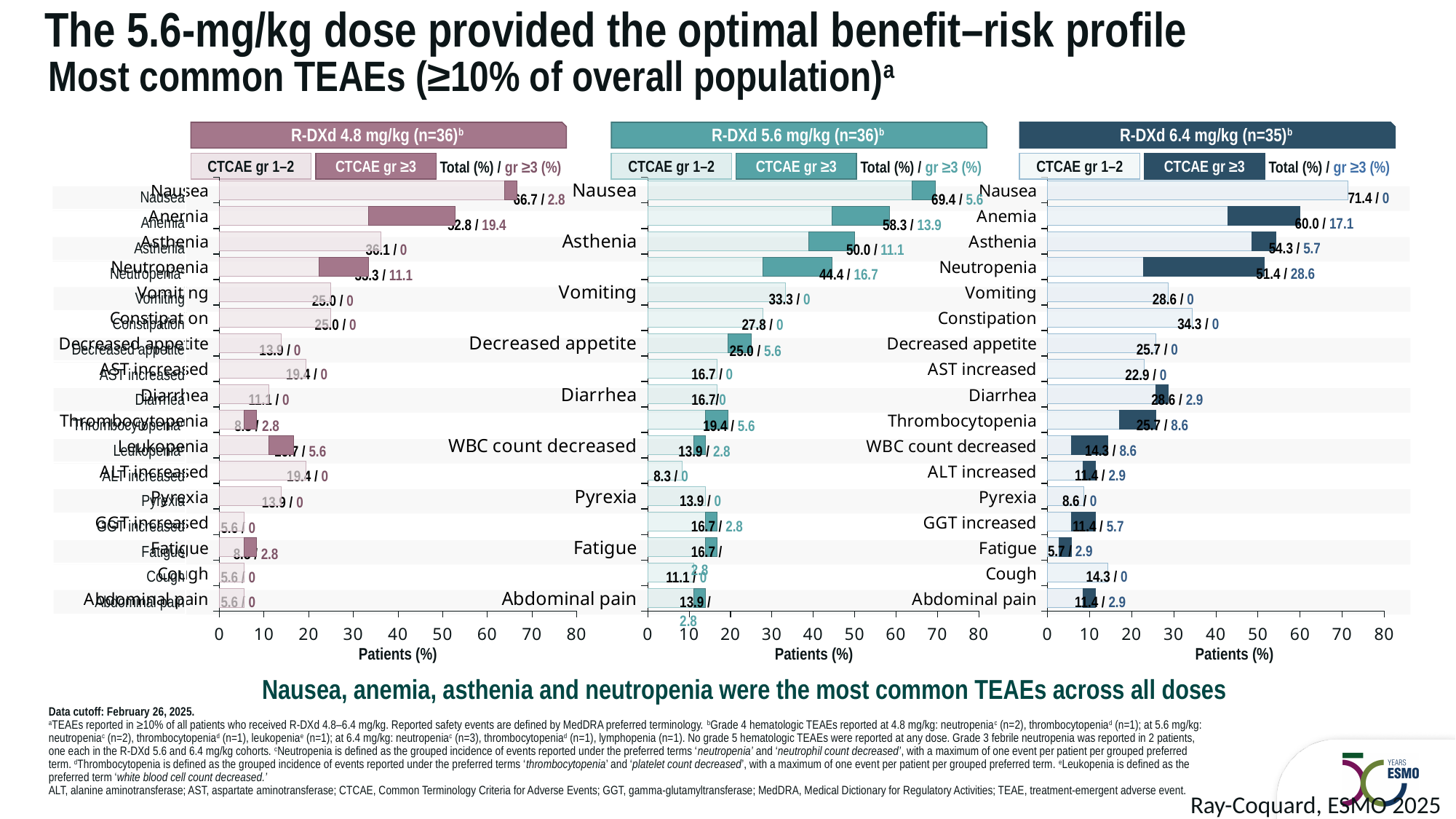
How many TEAE categories are listed in the R-DXd 6.4 mg/kg chart? 17 In the R-DXd 6.4 mg/kg chart, what is the difference between the total percentages for anemia and asthenia? 5.7 In the R-DXd 5.6 mg/kg chart, what is the total percentage of patients with nausea? 69.4 What is the x-axis label on the R-DXd 4.8 mg/kg chart? Patients (%) In the R-DXd 4.8 mg/kg chart, is the total percentage for asthenia greater or less than 30? greater In the R-DXd 6.4 mg/kg chart, what is the grade ≥3 percentage for neutropenia? 28.6 What type of chart is used to show the TEAEs for each dose? Bar chart In the R-DXd 6.4 mg/kg chart, which TEAE has the highest total percentage? Nausea How many series does the legend of the R-DXd 5.6 mg/kg chart list? 2 In the R-DXd 4.8 mg/kg chart, what is the total percentage of patients with anemia? 52.8 In the R-DXd 5.6 mg/kg chart, which has a higher total percentage: vomiting or constipation? Vomiting In the R-DXd 5.6 mg/kg chart, which TEAE has the lowest total percentage? ALT increased